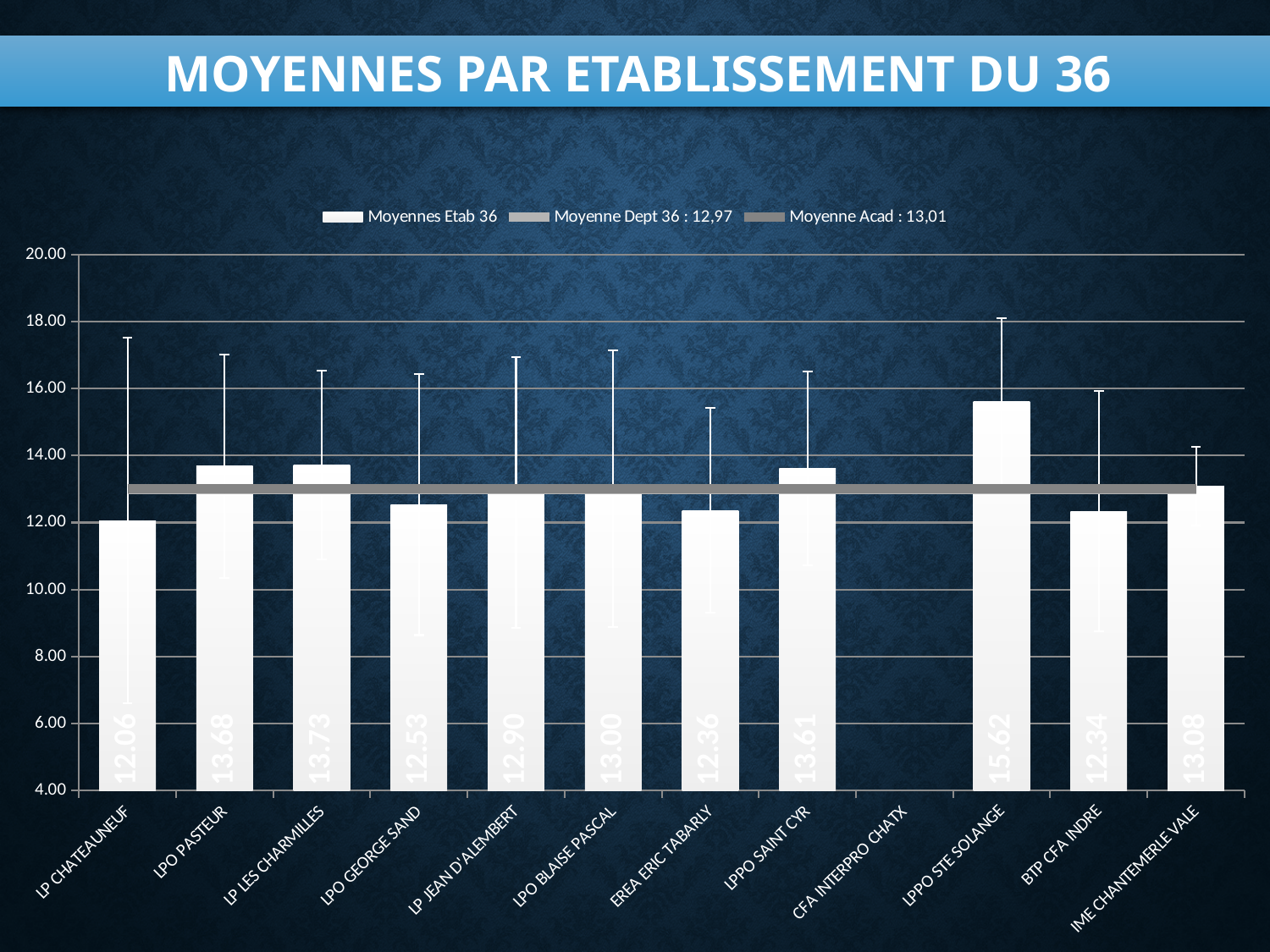
What is the difference between the values for LPPO SAINT CYR and EREA ERIC TABARLY? 1.25 What is the difference between the values for LPPO STE SOLANGE and LP CHATEAUNEUF? 3.56 Which establishment has the highest value? LPPO STE SOLANGE What kind of chart is shown on the slide? bar chart What is the value for LPO BLAISE PASCAL? 13.00 Which is larger, the value for LPO PASTEUR or the value for LPO GEORGE SAND? LPO PASTEUR What is the value for LP CHATEAUNEUF? 12.06 What value does the legend give for Moyenne Dept 36? 12,97 Which establishment has the lowest value? LP CHATEAUNEUF How many series does the legend list? 3 What is the value for LPPO STE SOLANGE? 15.62 Is the value for LPPO STE SOLANGE greater or less than 14.00? greater